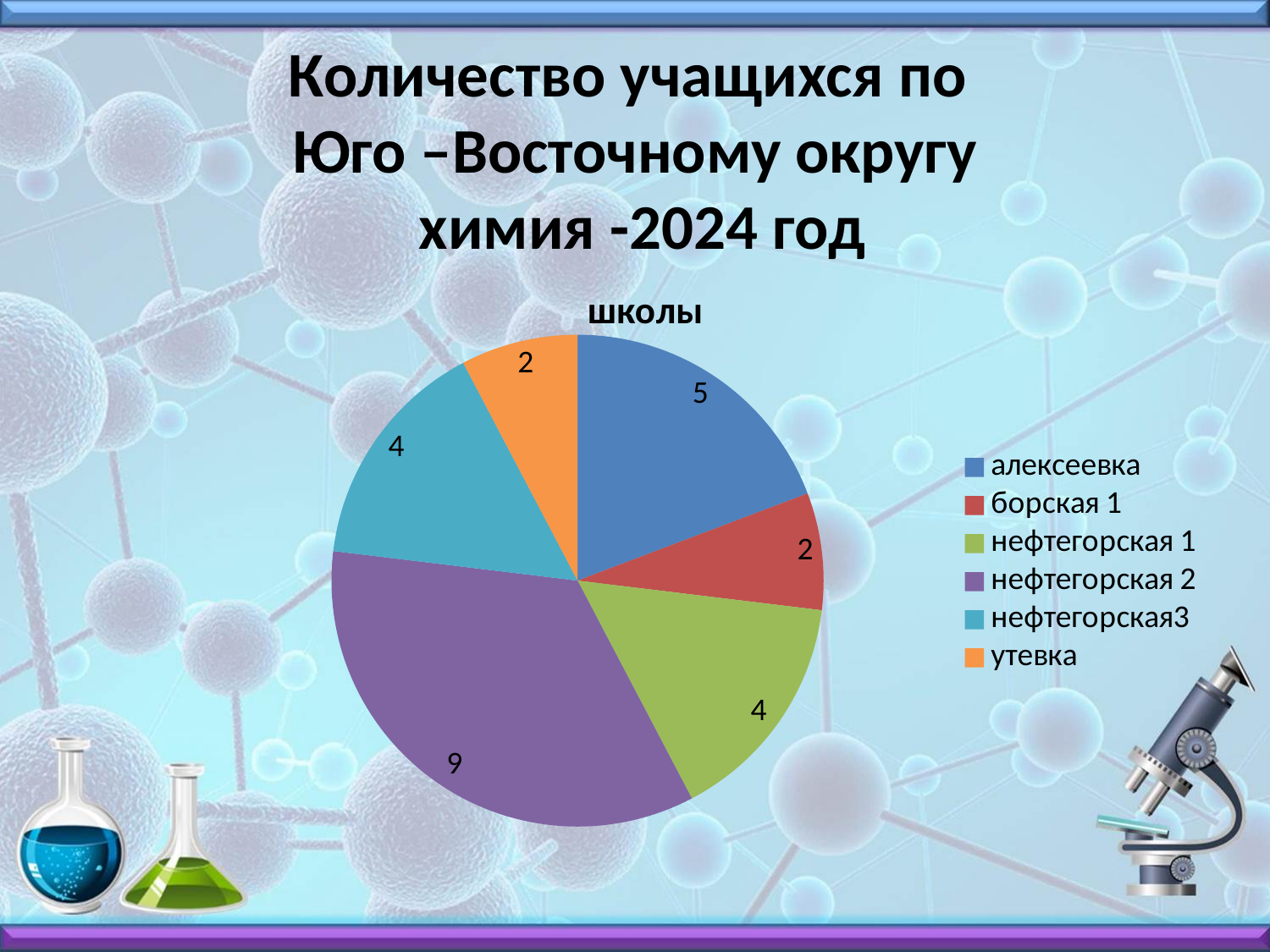
How many slices does the pie chart have? 6 Which is larger, the value for алексеевка or the value for нефтегорская 1? алексеевка What is the total of all slices in the pie chart? 26 What is the value for утевка? 2 Which colour represents борская 1 in the legend? red What is the value for нефтегорская 2? 9 What is the value for алексеевка? 5 How many entries does the legend list? 6 What kind of chart is shown on the slide? pie chart What is the title of the chart? школы Which school has the largest slice? нефтегорская 2 What is the difference between the values for нефтегорская 2 and алексеевка? 4